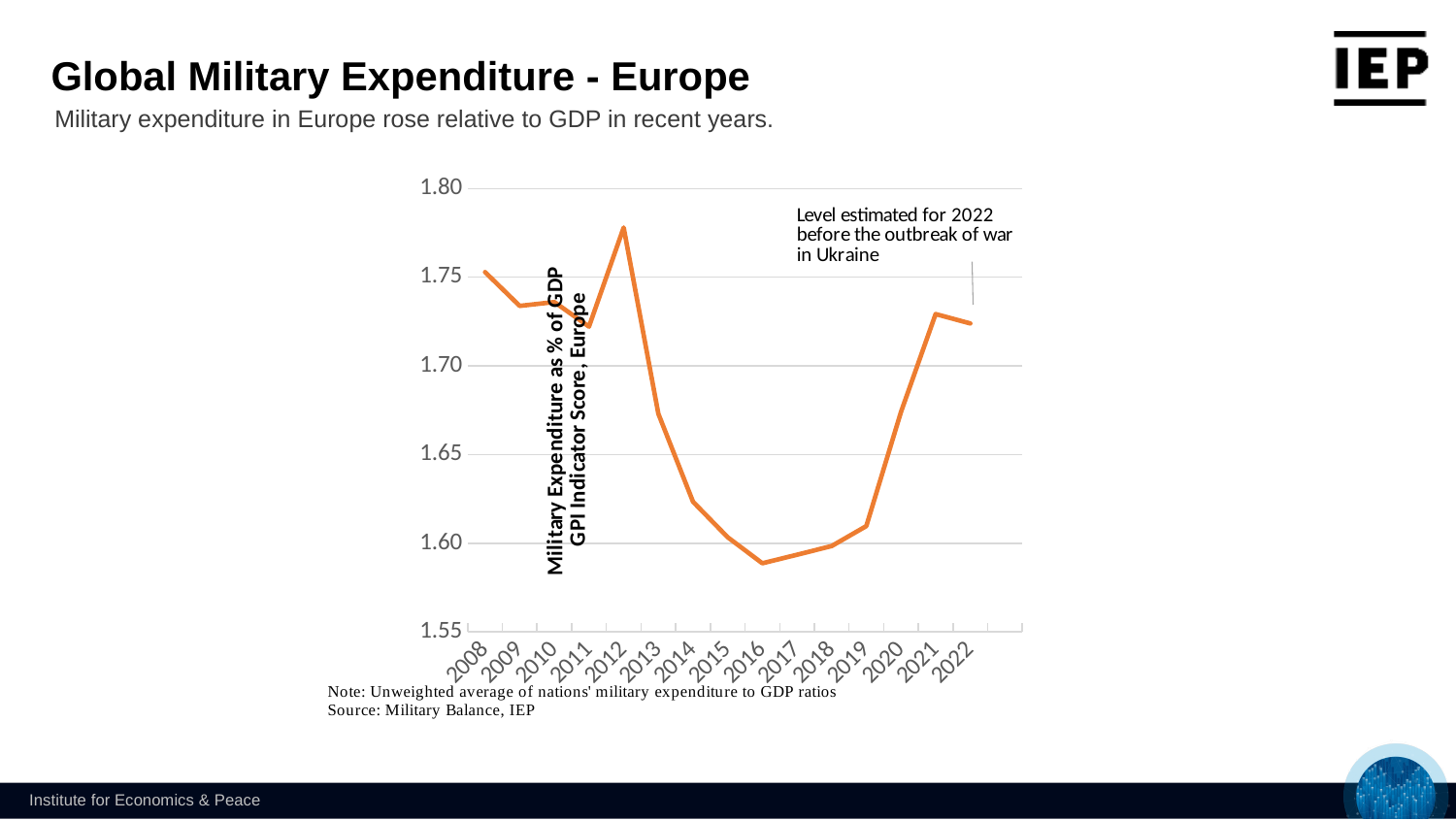
Do the values rise or fall between 2012 and 2016? fall Is the value for 2014 greater or less than 1.65? less How many years are plotted along the x axis? 15 Is the value for 2012 greater or less than 1.75? greater Is the value for 2016 greater or less than 1.60? less Which year has the larger value, 2013 or 2019? 2013 In which year does the line reach its highest value? 2012 What kind of chart is shown on the slide? line chart What is the label on the y axis of the chart? Military Expenditure as % of GDP GPI Indicator Score, Europe In which year does the line reach its lowest value? 2016 Do the values rise or fall between 2017 and 2021? rise